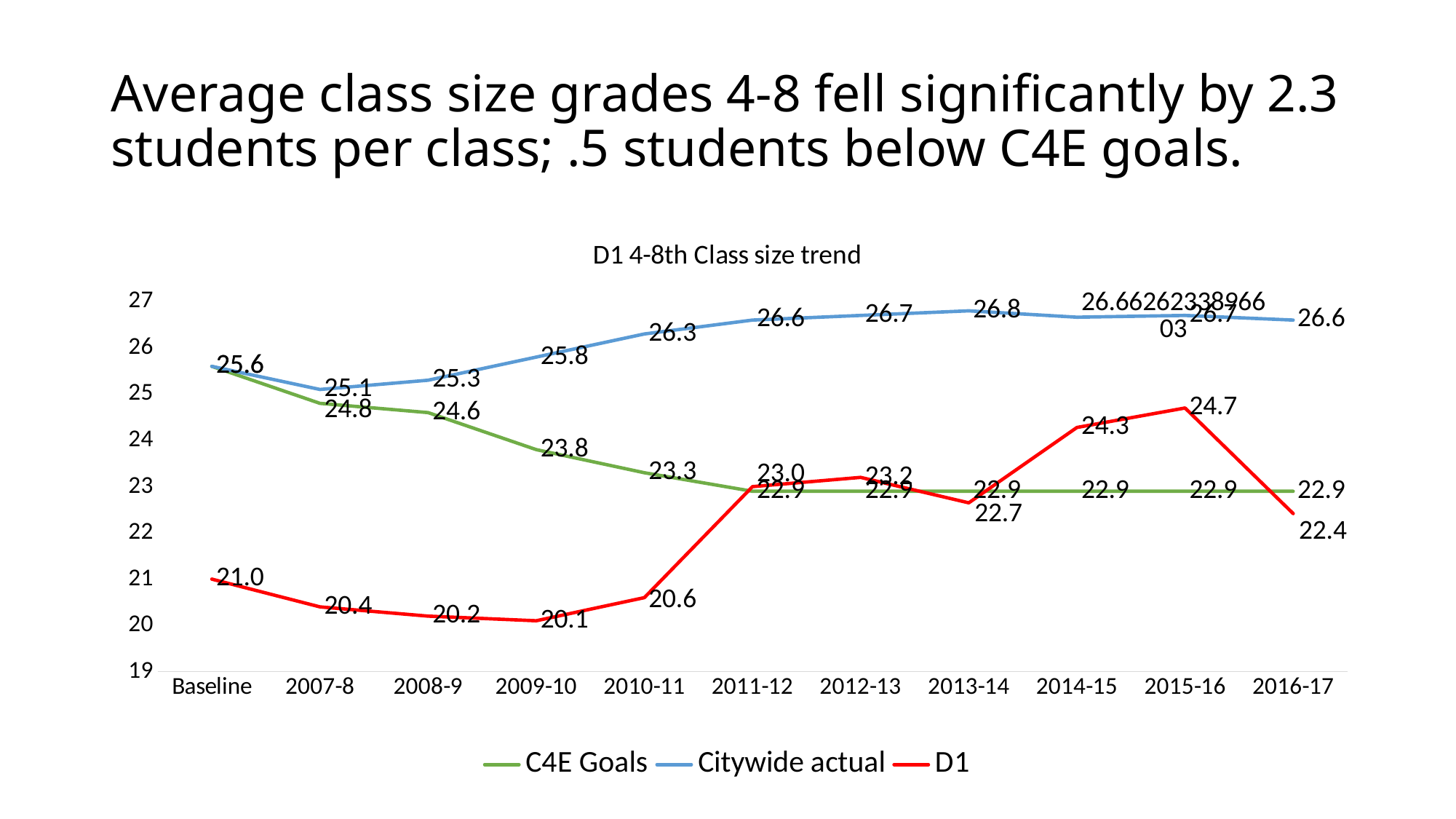
By how much did the D1 value fall from 2015-16 to 2016-17? 2.3 Does the C4E Goals series rise or fall from Baseline to 2011-12? Fall How many categories are shown on the x axis? 11 In which year does the D1 series reach its lowest value? 2009-10 In 2014-15, which is larger: the D1 value or the C4E Goals value? D1 What is the D1 value for 2016-17? 22.4 What is the Citywide actual value for 2013-14? 26.8 What is the C4E Goals value for 2009-10? 23.8 What kind of chart is shown on the slide? Line chart In which year does the D1 series reach its highest value? 2015-16 What is the difference between the Citywide actual and C4E Goals values in 2016-17? 3.7 How many series does the legend list? 3